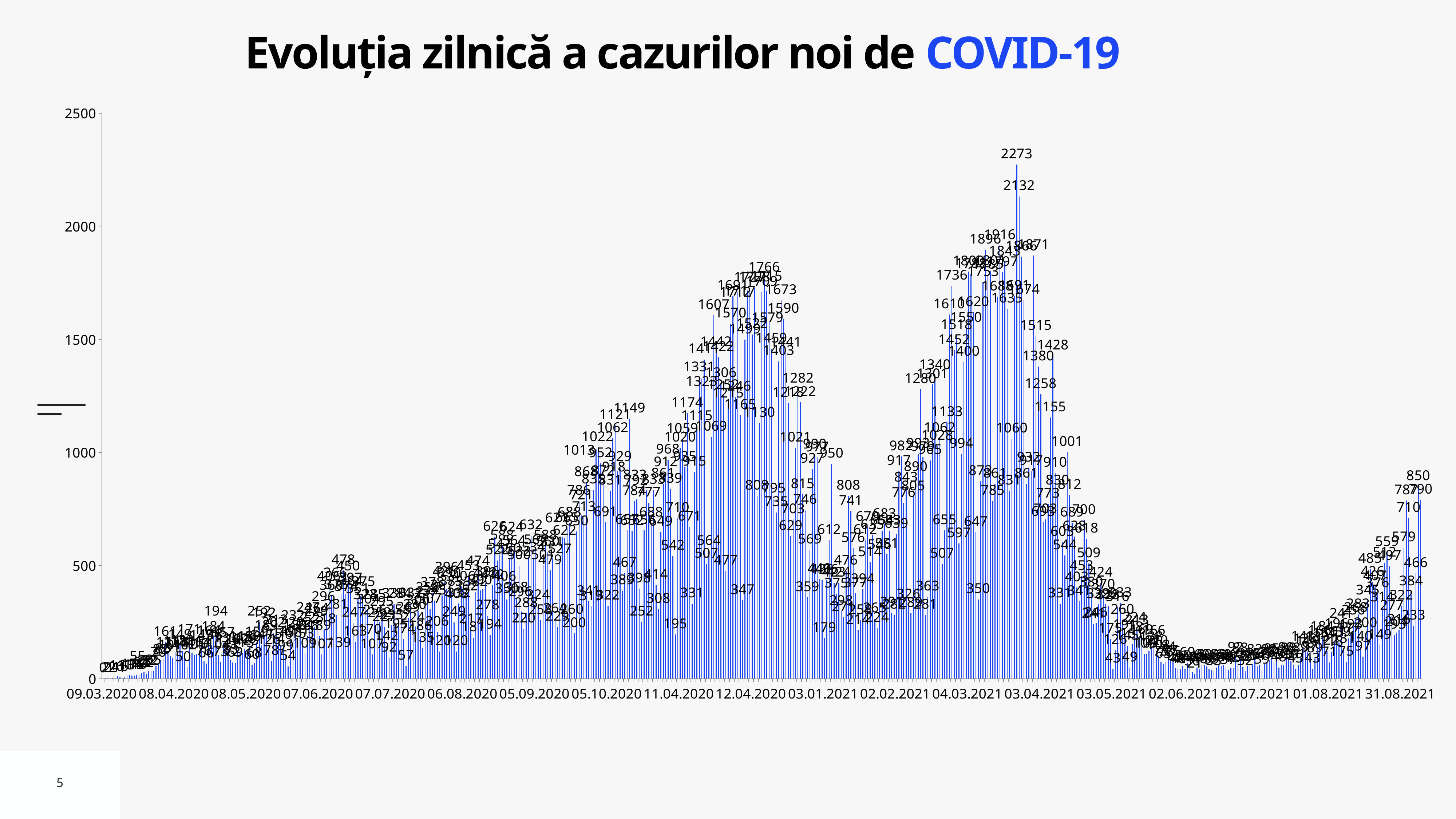
What is the second highest daily value labelled on the chart, just below the 2273 peak? 2132 What is the highest daily value labelled on the chart? 2273 Are the daily values around 02.06.2021 greater or less than 500? less What is the title of the chart? Evoluția zilnică a cazurilor noi de COVID-19 What is the difference between the two highest labelled values, 2273 and 2132? 141 Is the tallest bar on the chart greater or less than 2000? greater Which peak is higher: the one near 12.04.2020 or the one near 03.04.2021? the one near 03.04.2021 Do the daily values rise or fall between 09.03.2020 and 08.04.2020? rise Do the daily values rise or fall between 03.04.2021 and 03.05.2021? fall What kind of chart is shown on the slide? bar chart What is the last date label shown on the horizontal axis? 31.08.2021 What is the highest tick value shown on the vertical axis? 2500